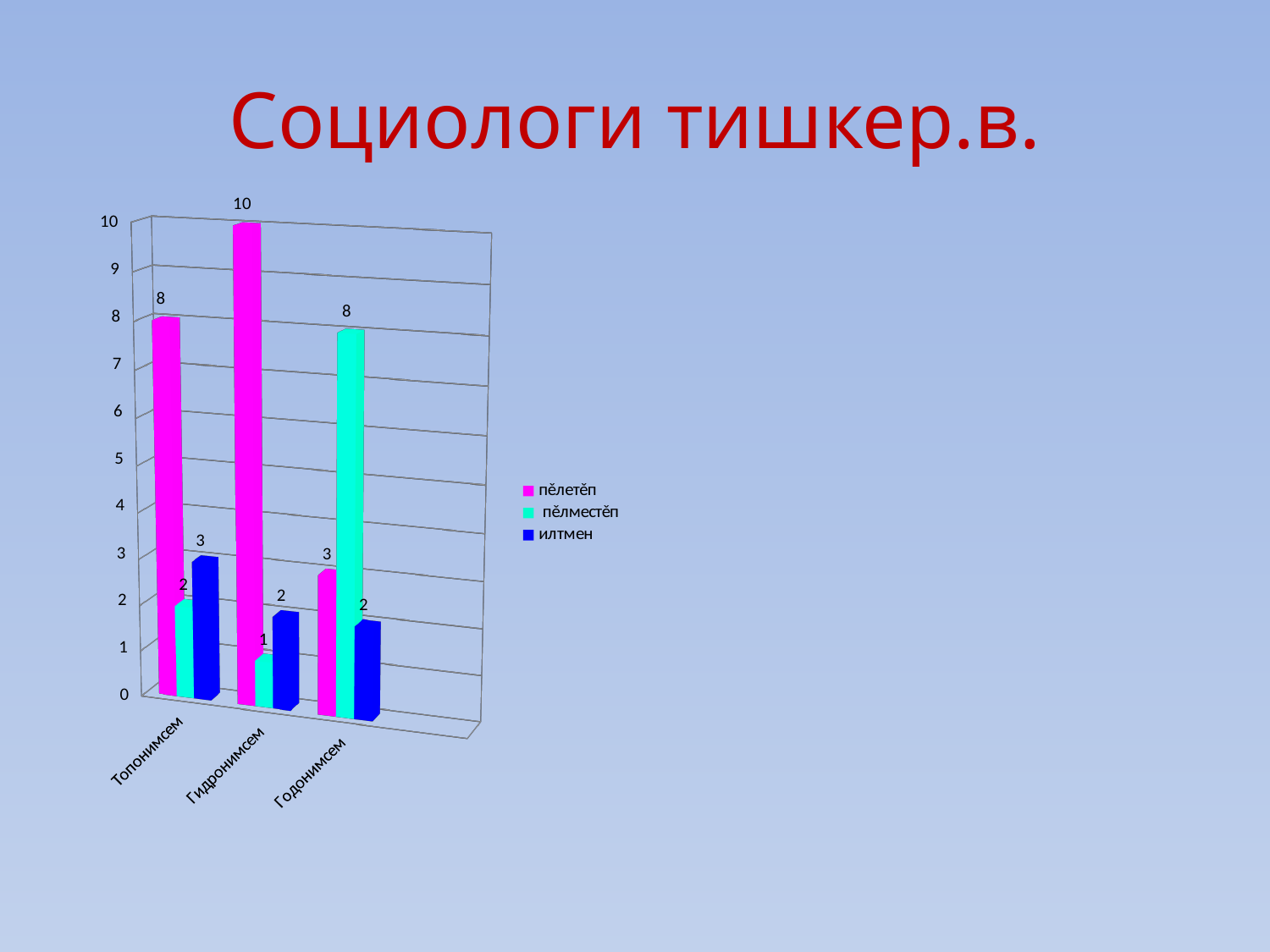
In which category does the пĕлместĕп series have its lowest value? Гидронимсем What is the value for илтмен in the Годонимсем category? 2 What colour represents the илтмен series in the legend? Blue What is the difference between the пĕлетĕп value for Гидронимсем and the пĕлетĕп value for Годонимсем? 7 What is the value for пĕлместĕп in the Гидронимсем category? 1 How many categories are shown on the x axis? 3 How many series does the legend list? 3 In which category does the пĕлетĕп series reach its highest value? Гидронимсем What kind of chart is shown on the slide? Bar chart What is the value for пĕлместĕп in the Годонимсем category? 8 Which is larger in the Годонимсем category: пĕлетĕп or пĕлместĕп? пĕлместĕп What is the value for пĕлетĕп in the Топонимсем category? 8